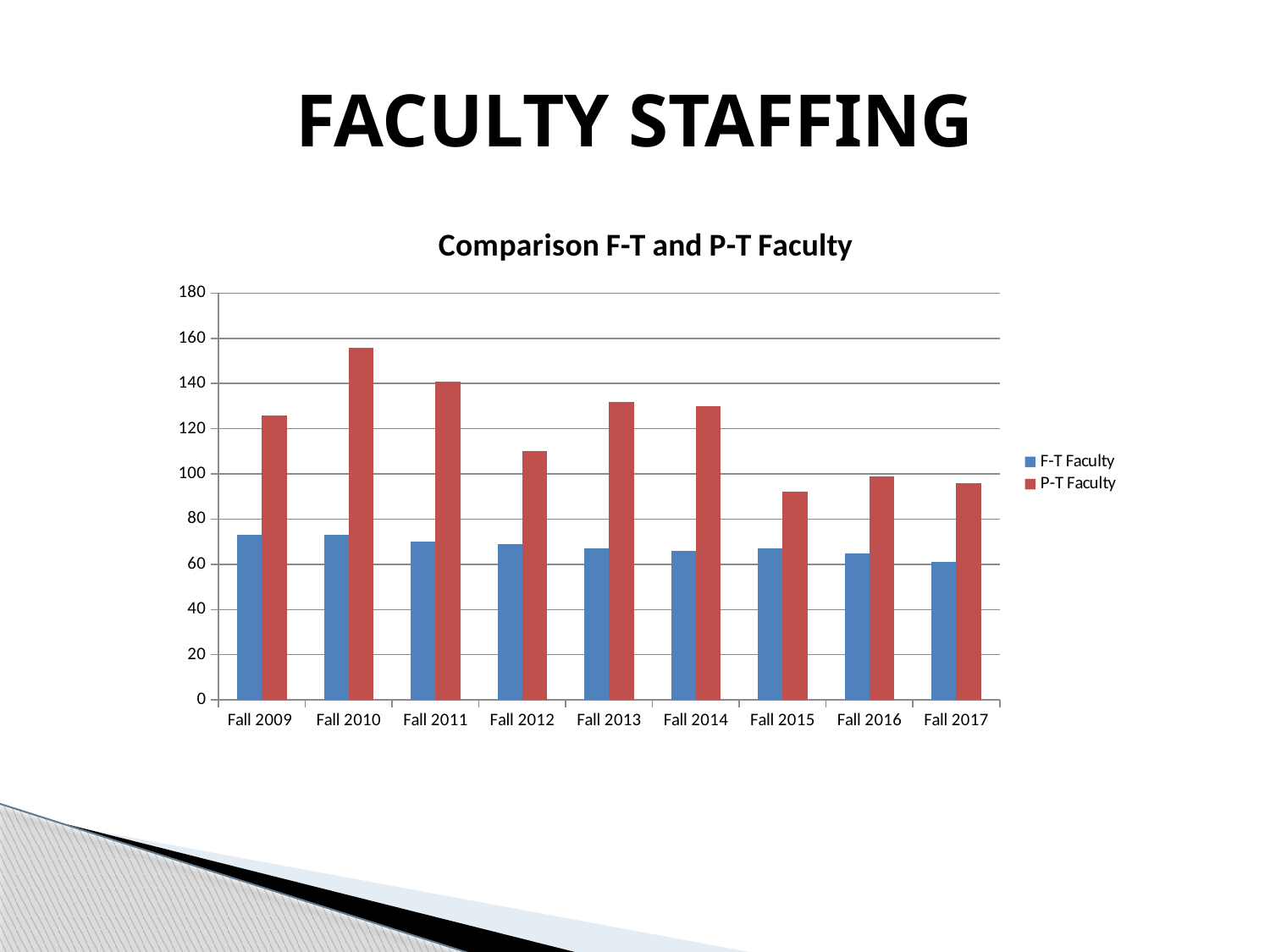
Which is larger, the P-T Faculty value for Fall 2011 or for Fall 2013? Fall 2011 How many semesters (categories) are shown on the x axis? 9 Which colour represents P-T Faculty in the chart? Red Is the P-T Faculty value for Fall 2012 greater or less than 120? less In which semester is the P-T Faculty value highest? Fall 2010 Does the F-T Faculty series generally rise or fall from Fall 2009 to Fall 2017? Fall What type of chart is shown on the slide? Bar chart Is the F-T Faculty value for Fall 2017 greater or less than 80? less In which semester is the F-T Faculty value lowest? Fall 2017 What is the title of the chart? Comparison F-T and P-T Faculty Is the P-T Faculty value for Fall 2010 greater or less than 140? greater How many series does the legend list? 2